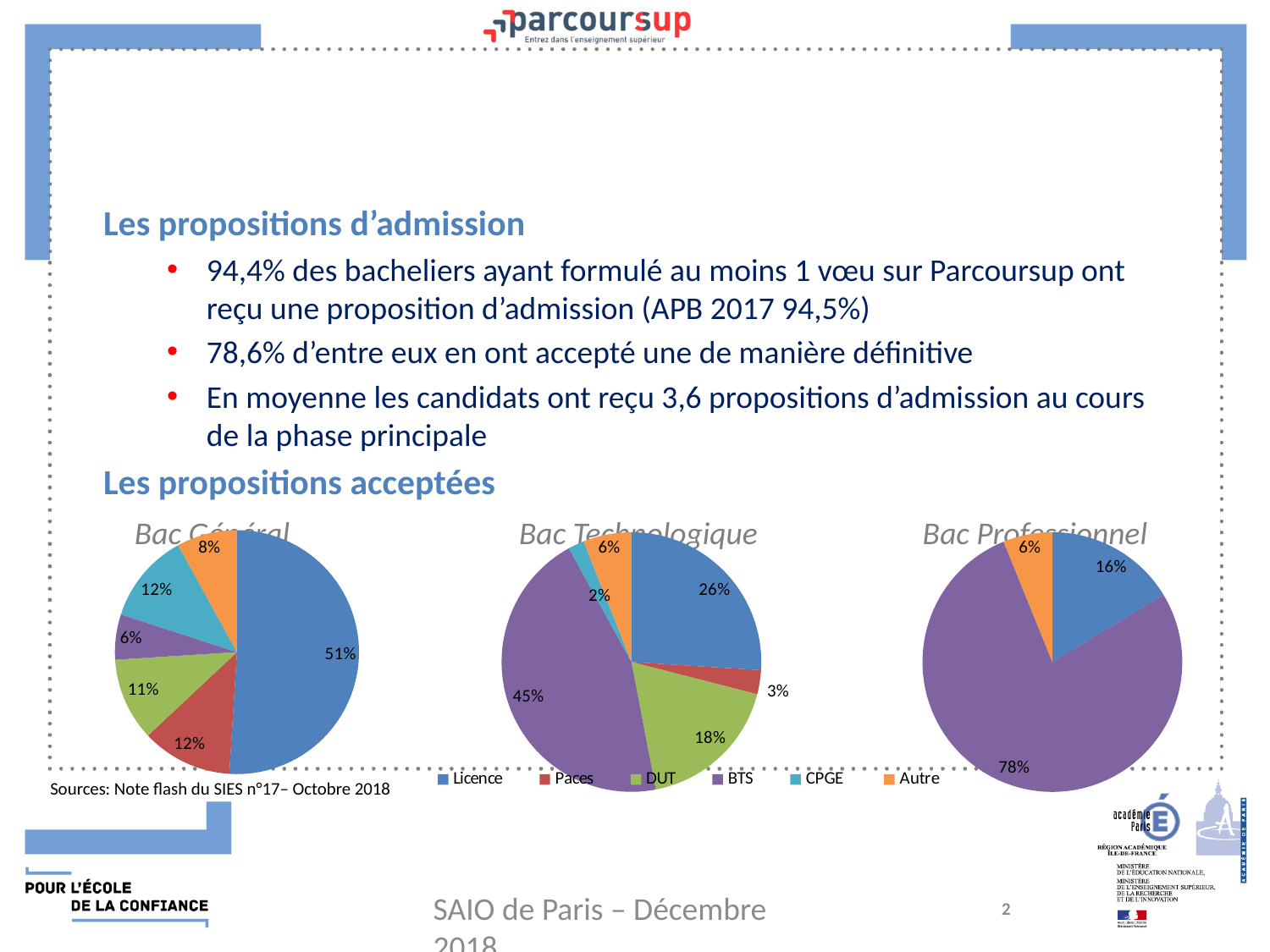
In the Bac Technologique pie chart, what share goes to DUT? 18% In the Bac Technologique pie chart, what share goes to BTS? 45% In the Bac Général pie chart, which category has the largest share? Licence In the Bac Professionnel pie chart, what share goes to BTS? 78% In the Bac Technologique pie chart, which category has the smallest share? CPGE In the Bac Général pie chart, what share goes to Licence? 51% What type of chart is used for Bac Général, Bac Technologique and Bac Professionnel? Pie chart In the Bac Professionnel pie chart, which is larger, Licence or Autre? Licence In the Bac Général pie chart, what is the difference between the Licence share and the Paces share? 39% How many series does the shared legend list? 6 In the legend, which category is shown in orange? Autre In the Bac Technologique pie chart, what is the difference between the BTS share and the Licence share? 19%